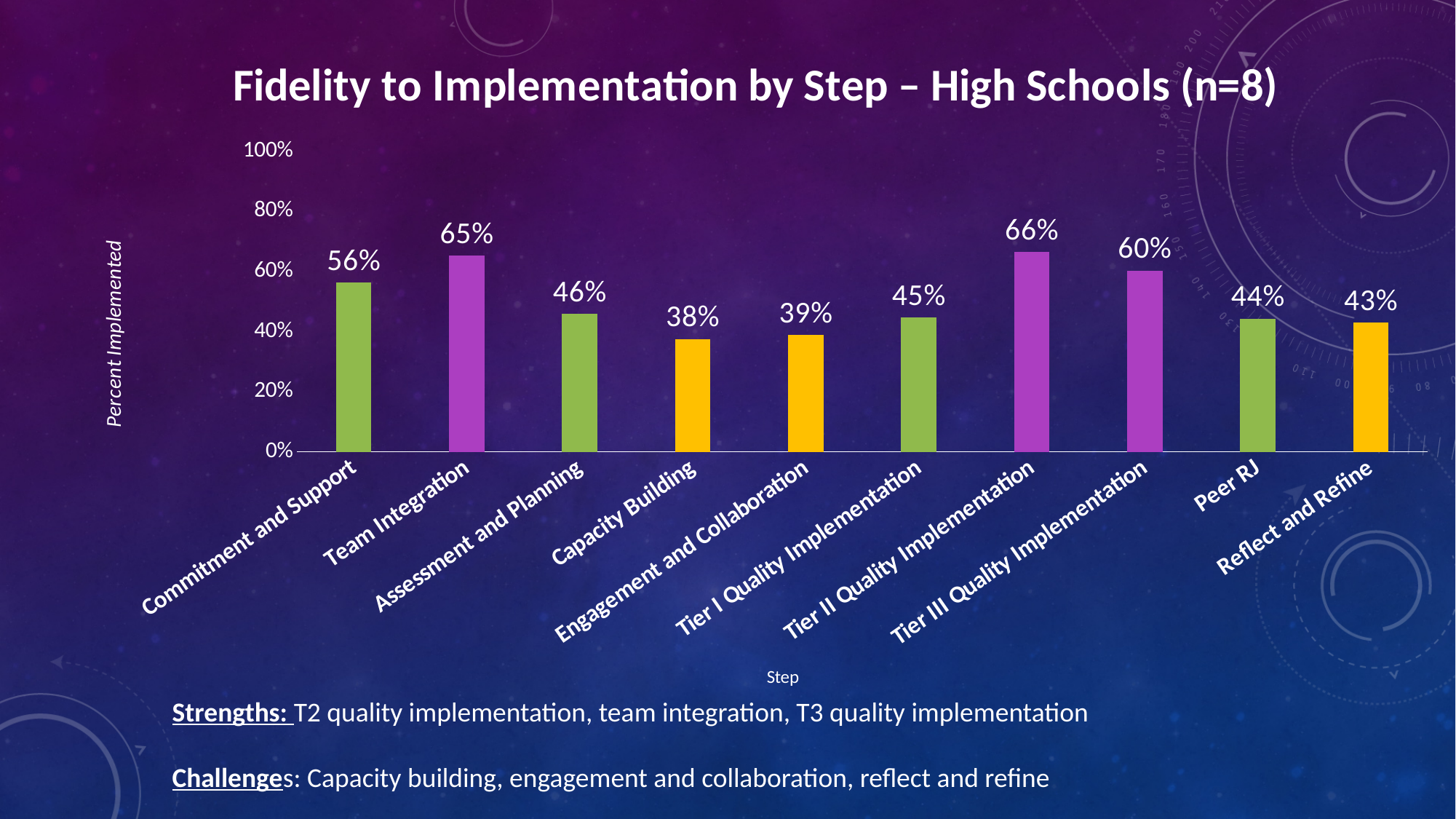
Which step has the highest percent implemented? Tier II Quality Implementation What is the difference between Tier II Quality Implementation and Capacity Building? 28% Which step has the lowest percent implemented? Capacity Building How many steps are shown on the x axis? 10 What is the label of the y axis? Percent Implemented What is the value for Tier III Quality Implementation? 60% What is the value for Capacity Building? 38% Which is larger, Commitment and Support or Assessment and Planning? Commitment and Support What is the title of the chart? Fidelity to Implementation by Step – High Schools (n=8) Is the value for Peer RJ greater or less than 60%? less What is the value for Team Integration? 65% What kind of chart is this? bar chart